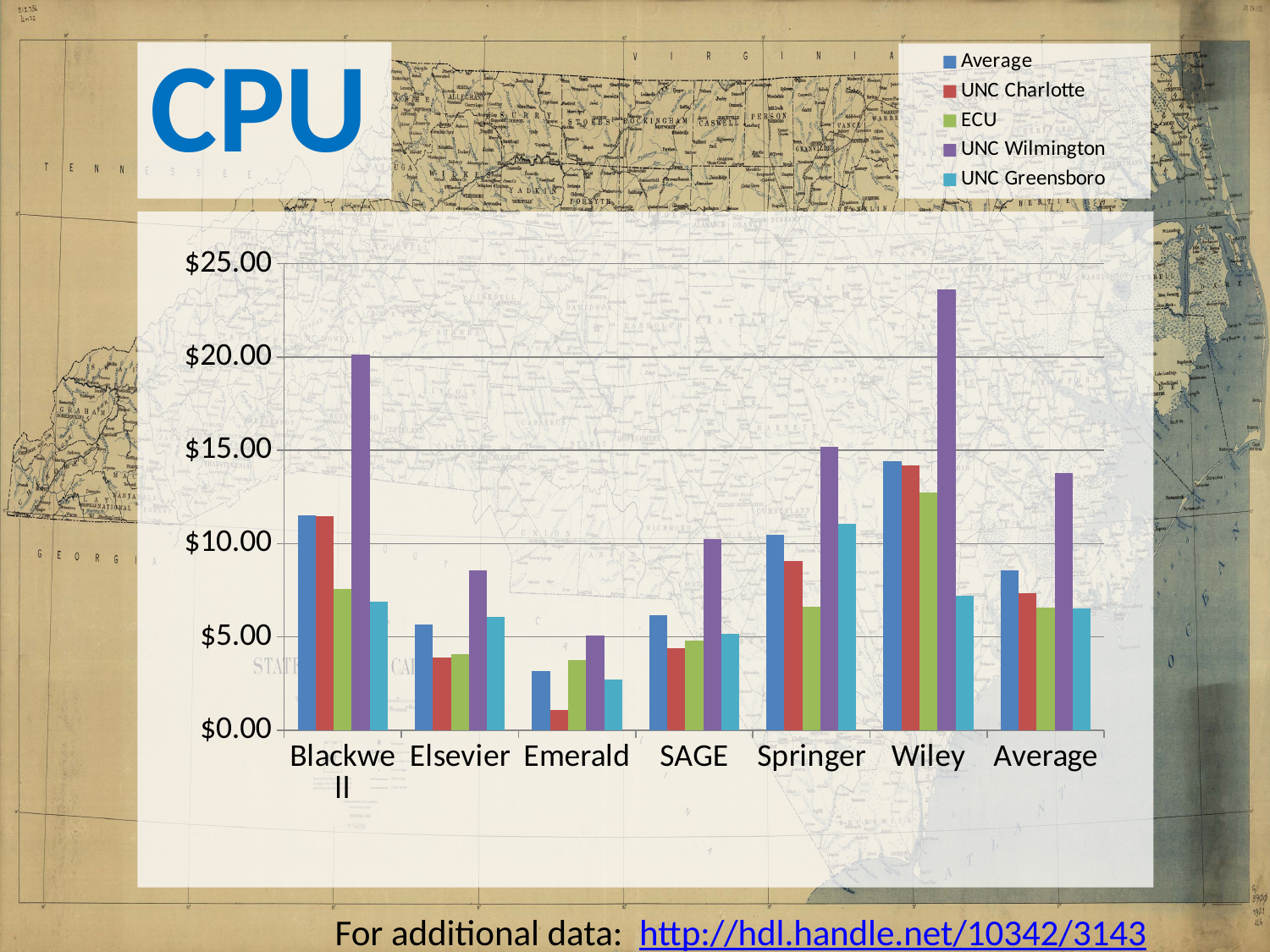
For which category is the UNC Charlotte bar the lowest? Emerald Is the UNC Charlotte value for Emerald greater or less than $5.00? less Is the UNC Wilmington value for Wiley greater or less than $20.00? greater How many series does the legend list? 5 Is the UNC Greensboro value for Springer greater or less than $10.00? greater For which category is the UNC Wilmington bar the highest? Wiley How many categories are shown along the x axis? 7 What kind of chart is shown on the slide? bar chart For Springer, which is larger: the UNC Wilmington value or the UNC Greensboro value? UNC Wilmington Which series is shown in purple in the legend? UNC Wilmington What is the title of the chart? CPU